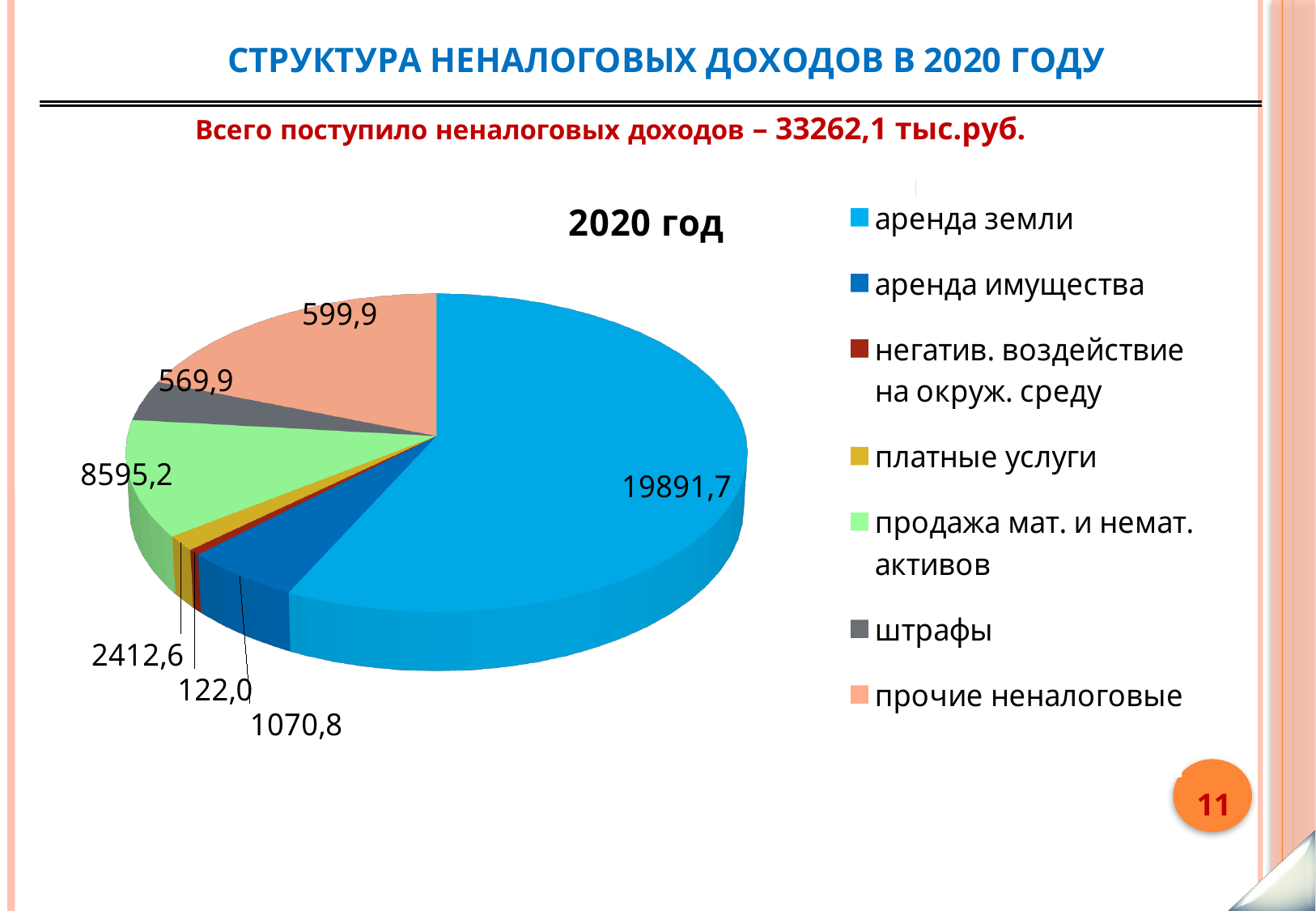
What is the value for штрафы? 569,9 Which category has the smallest value? негатив. воздействие на окруж. среду How many slices does the pie chart have? 7 What is the value for аренда земли? 19891,7 What is the difference between the values for аренда земли and продажа мат. и немат. активов? 11296,5 Which is larger, the value for платные услуги or the value for аренда имущества? платные услуги What is the title of the chart? 2020 год Which category has the largest slice of the pie? аренда земли What is the value for продажа мат. и немат. активов? 8595,2 What is the value for негатив. воздействие на окруж. среду? 122,0 What is the value for аренда имущества? 1070,8 What kind of chart is shown on the slide? Pie chart